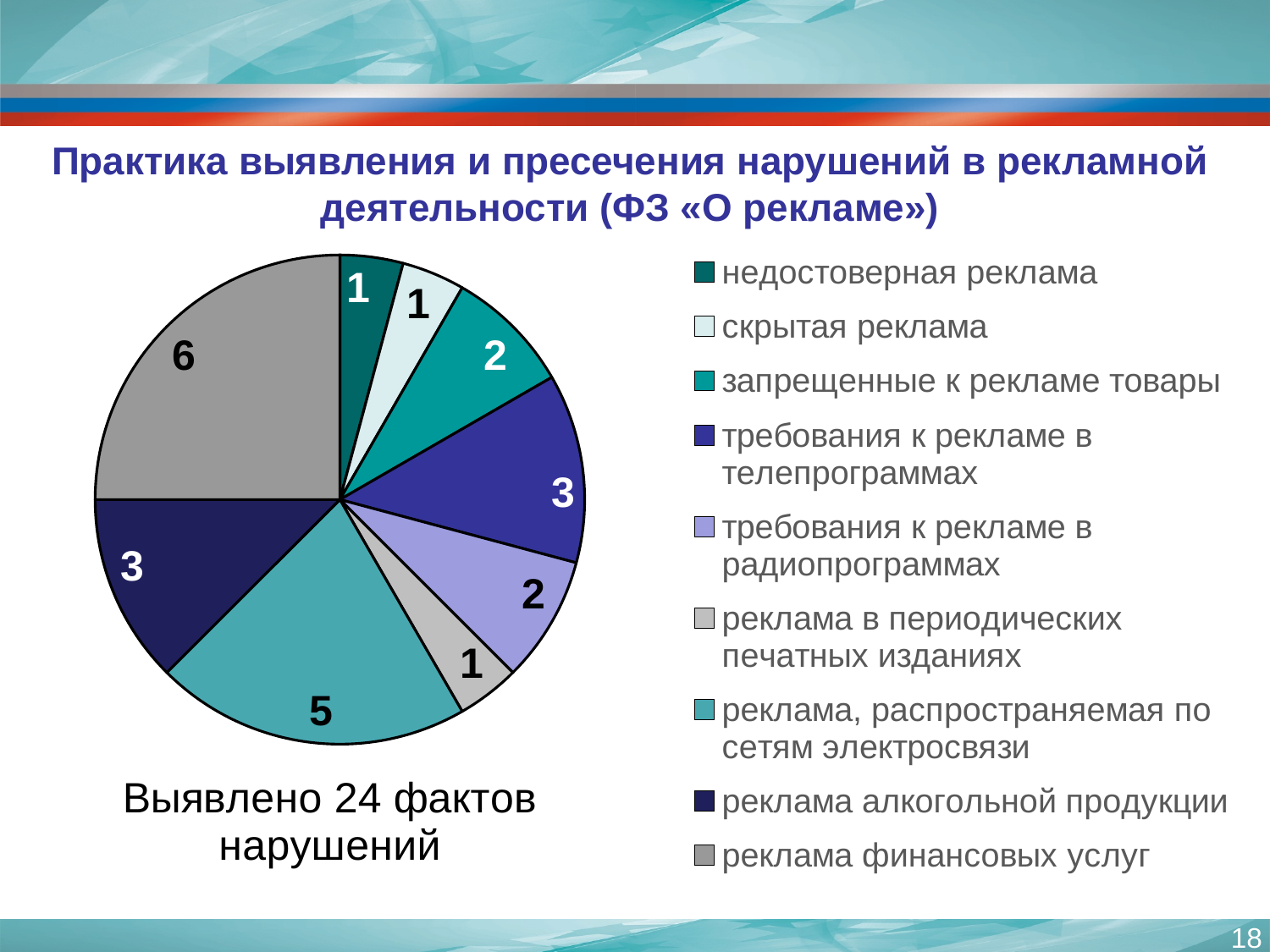
How many slices does the pie chart have? 9 What is the value for "запрещенные к рекламе товары" in the pie chart? 2 What kind of chart is shown on the slide? pie chart Which is larger: the value for "реклама, распространяемая по сетям электросвязи" or the value for "требования к рекламе в радиопрограммах"? реклама, распространяемая по сетям электросвязи What share of the pie does "реклама финансовых услуг" represent? 25% Which category has the largest slice in the pie chart? реклама финансовых услуг What is the difference between the values for "реклама финансовых услуг" and "реклама алкогольной продукции"? 3 How many entries does the legend of the pie chart list? 9 What is the total number of violations stated below the pie chart? 24 What is the value for "реклама финансовых услуг" in the pie chart? 6 What is the value for "требования к рекламе в телепрограммах" in the pie chart? 3 What is the value for "реклама, распространяемая по сетям электросвязи" in the pie chart? 5